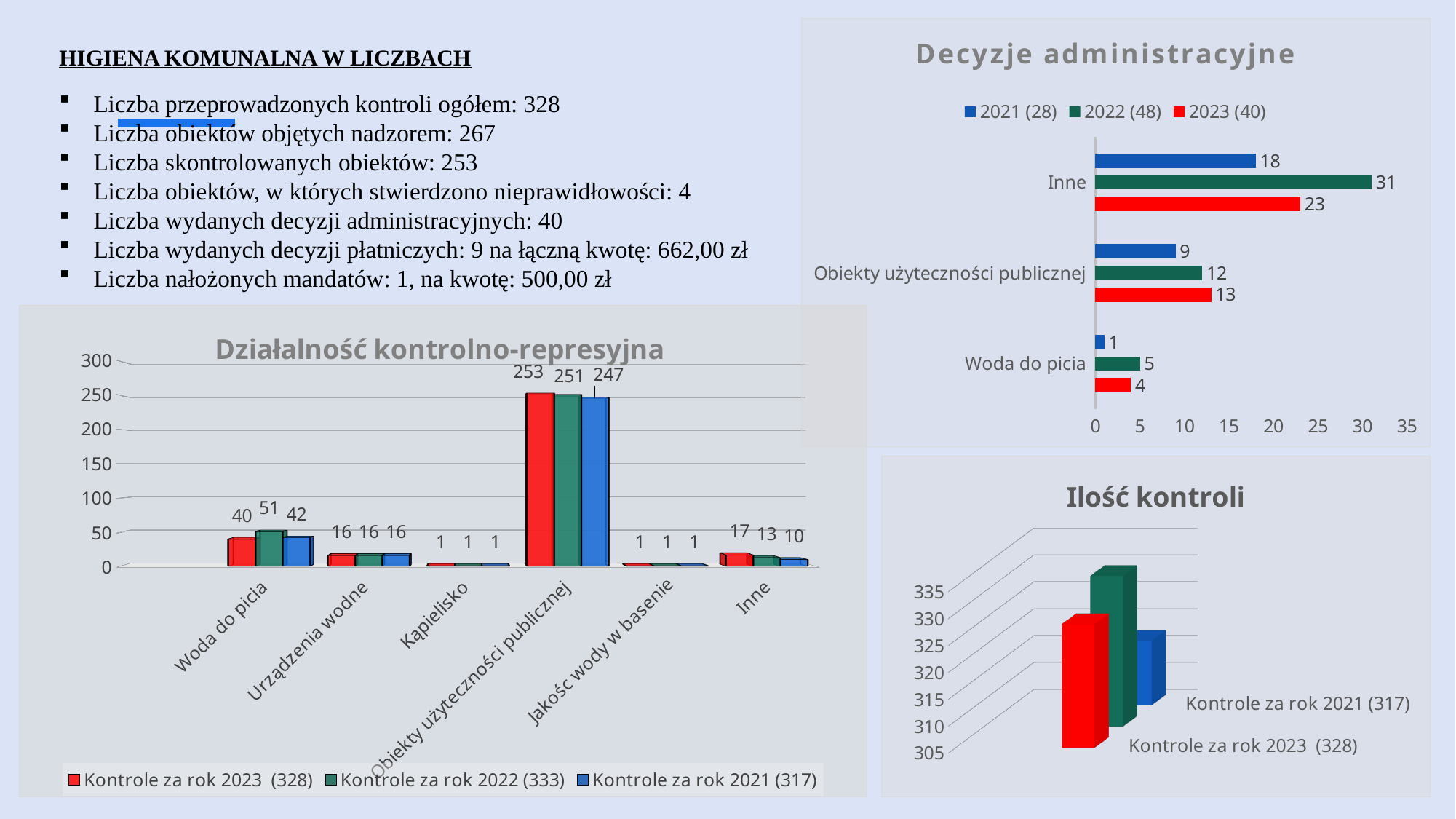
In the 'Działalność kontrolno-represyjna' chart, what is the difference between the 'Inne' values for 2023 and 2021? 7 What kind of chart is 'Decyzje administracyjne'? Bar chart In the 'Decyzje administracyjne' chart, what is the value for 'Woda do picia' in the 2021 series? 1 In the 'Decyzje administracyjne' chart, what is the value for 'Inne' in the 2022 series? 31 In the 'Ilość kontroli' chart, is the value for 'Kontrole za rok 2021 (317)' greater or less than 320? less How many categories are shown on the x axis of the 'Działalność kontrolno-represyjna' chart? 6 In the 'Działalność kontrolno-represyjna' chart, which category has the highest values across all series? Obiekty użyteczności publicznej In the 'Działalność kontrolno-represyjna' chart, what is the value for 'Woda do picia' in the 'Kontrole za rok 2022 (333)' series? 51 How many series does the legend of the 'Działalność kontrolno-represyjna' chart list? 3 In the 'Decyzje administracyjne' chart, which is larger for 'Obiekty użyteczności publicznej': the 2022 value or the 2023 value? 2023 (13) In the 'Decyzje administracyjne' chart, what is the difference between the 2022 and 2023 values for 'Inne'? 8 In the 'Działalność kontrolno-represyjna' chart, what is the value for 'Obiekty użyteczności publicznej' in the 'Kontrole za rok 2023 (328)' series? 253